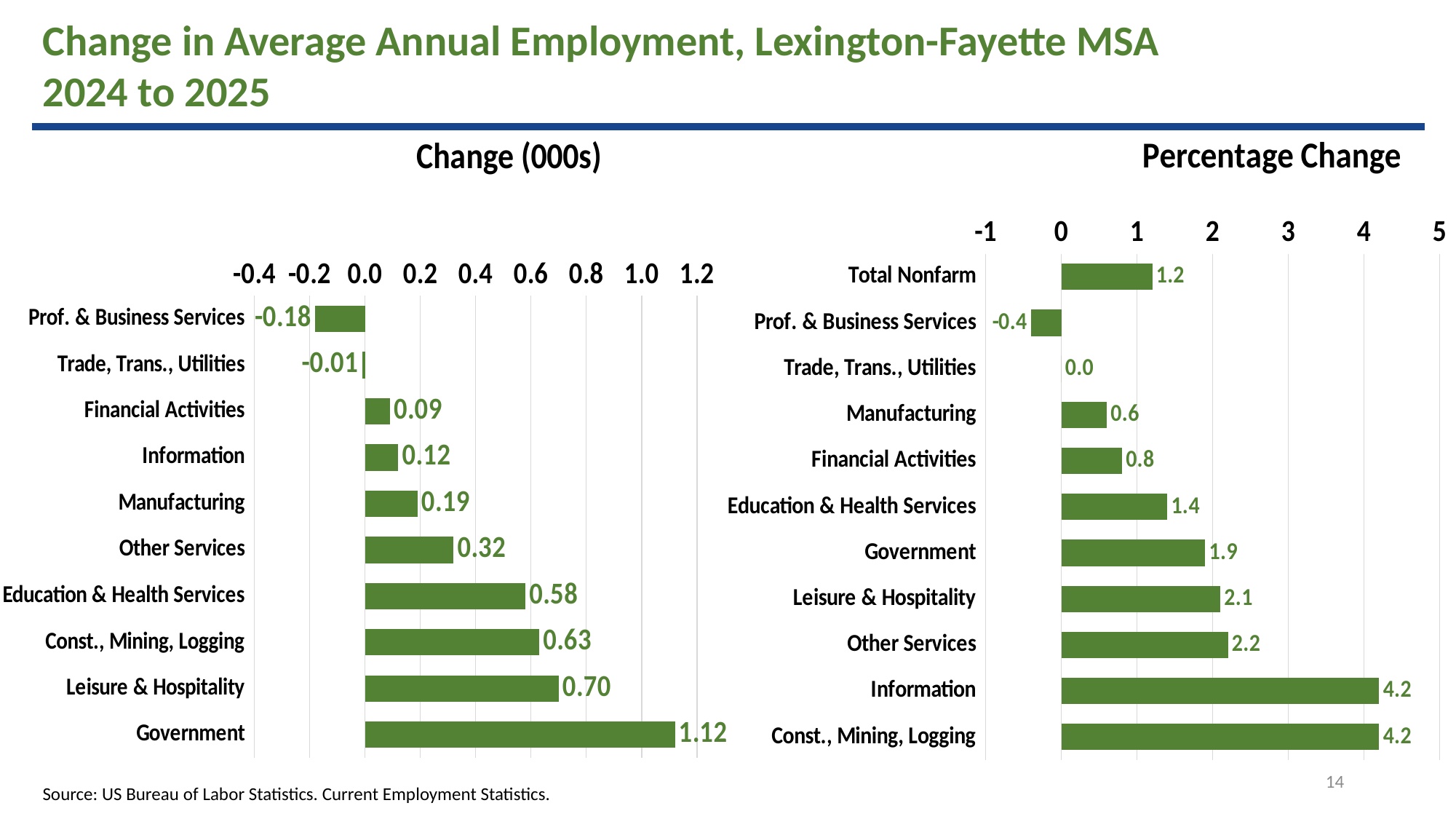
In the Change (000s) chart, how many categories are shown? 10 In the Change (000s) chart, which category has the lowest value? Prof. & Business Services In the Percentage Change chart, how many categories are shown? 11 In the Percentage Change chart, what is the difference between Information and Manufacturing? 3.6 In the Percentage Change chart, which category has the lowest value? Prof. & Business Services In the Percentage Change chart, what is the value for Total Nonfarm? 1.2 In the Change (000s) chart, what is the value for Government? 1.12 What type of chart is the Percentage Change chart? Bar chart In the Change (000s) chart, which is larger, Other Services or Manufacturing? Other Services In the Percentage Change chart, what is the value for Government? 1.9 In the Change (000s) chart, what is the value for Prof. & Business Services? -0.18 In the Change (000s) chart, what is the difference between Leisure & Hospitality and Education & Health Services? 0.12